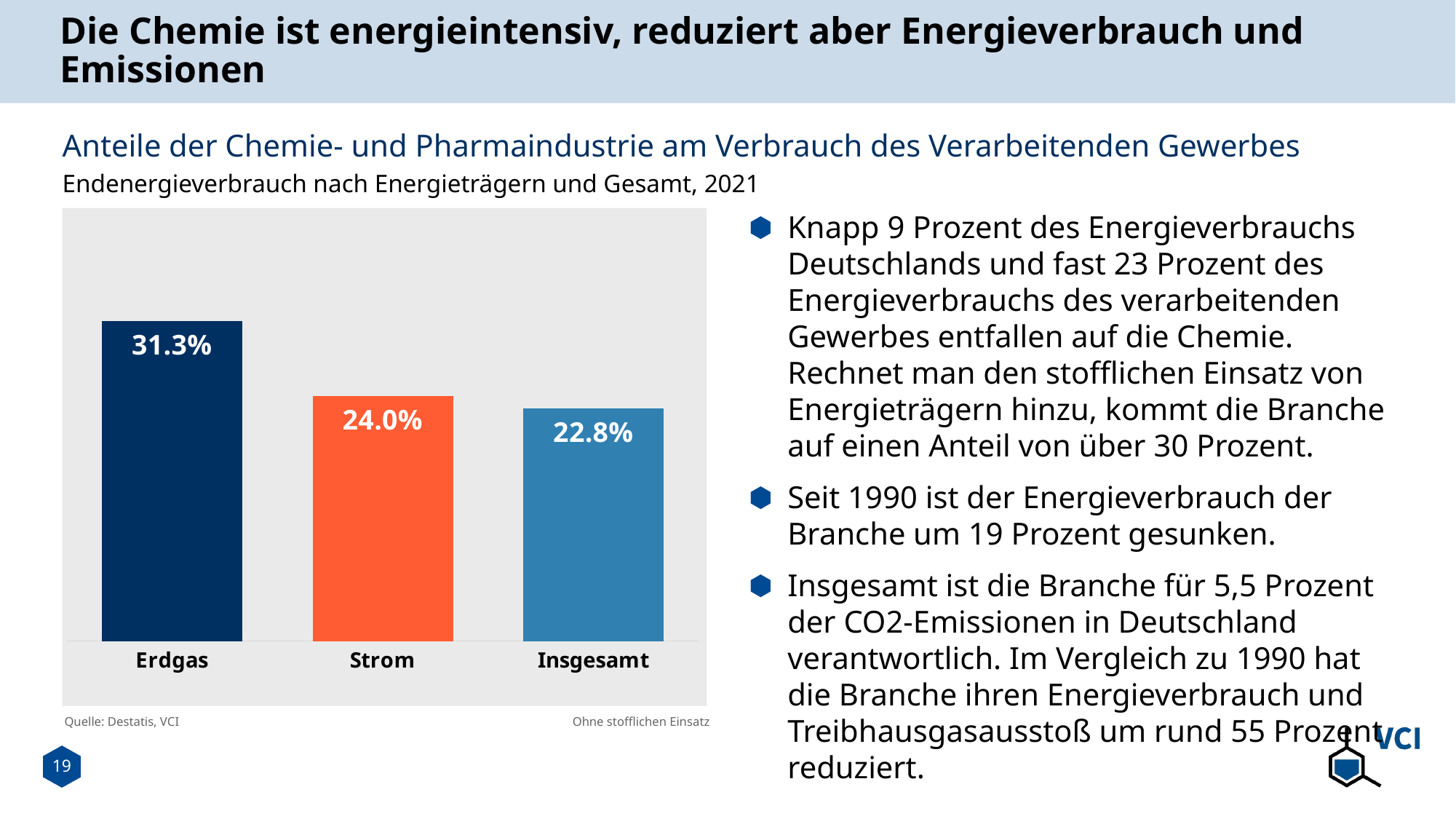
What is the value for Erdgas? 31.3% What is the value for Insgesamt? 22.8% How many categories are shown in the chart? 3 Which category has the lowest value? Insgesamt What kind of chart is shown on the slide? Bar chart Do the values rise or fall from left to right across the categories? Fall Which category has the highest value? Erdgas What is the difference between the values for Strom and Insgesamt? 1.2% What is the value for Strom? 24.0% What colour is the bar for Strom? Orange Which is larger, the value for Erdgas or the value for Insgesamt? Erdgas What is the difference between the values for Erdgas and Strom? 7.3%